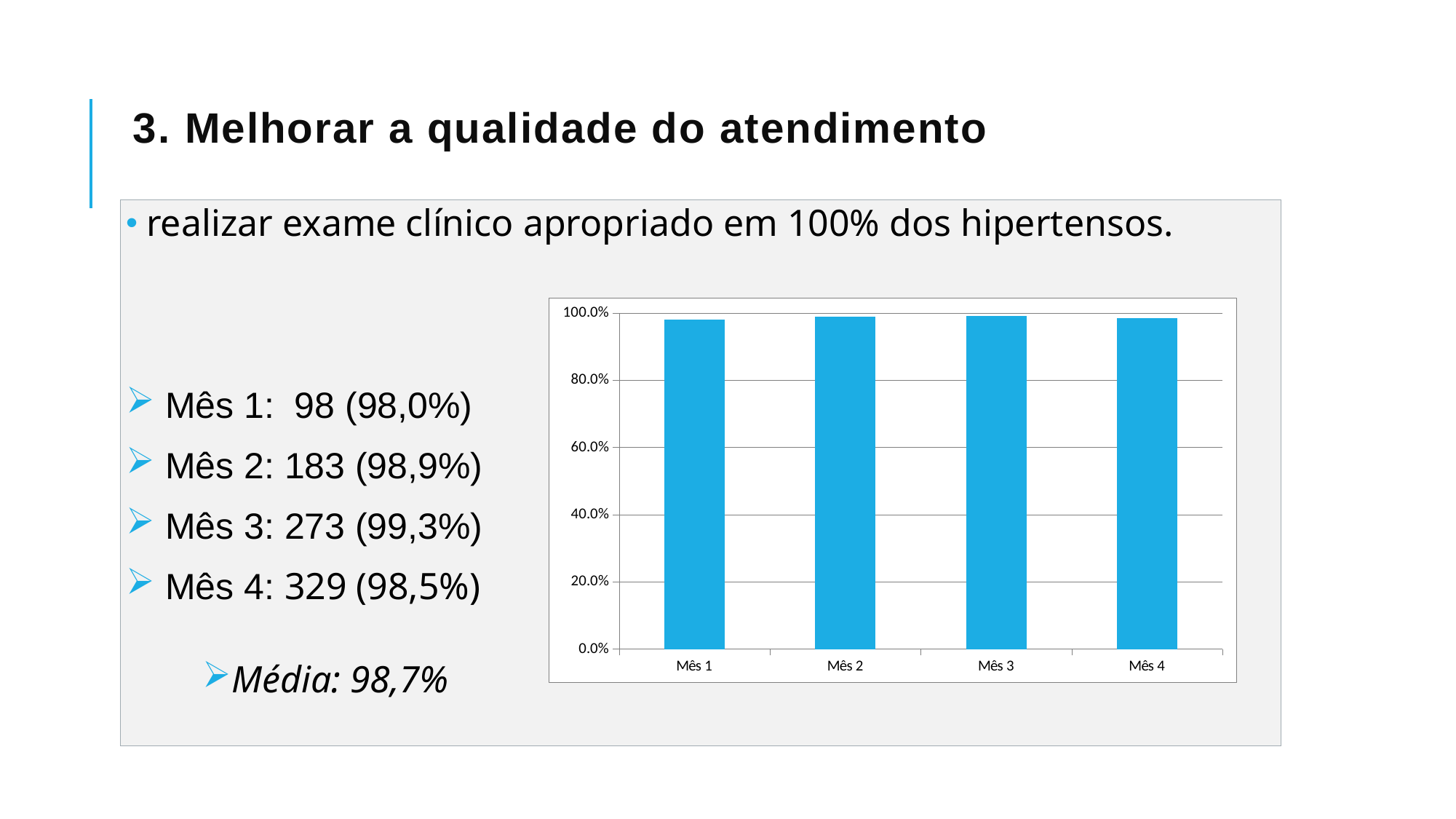
Is the value for Mês 4 greater or less than 80.0%? greater What is the label of the first category on the x axis of the chart? Mês 1 What is the difference between the values for Mês 3 and Mês 1? 1,3 percentage points Which month has the highest value on the chart? Mês 3 What is the value for Mês 2 on the chart? 98,9% What is the value for Mês 1 on the chart? 98,0% What is the value for Mês 4 on the chart? 98,5% Is the value for Mês 2 greater or less than 60.0%? greater How many categories (months) are plotted on the chart? 4 What kind of chart is shown on the slide? bar chart Which month has the lowest value on the chart? Mês 1 What is the value for Mês 3 on the chart? 99,3%